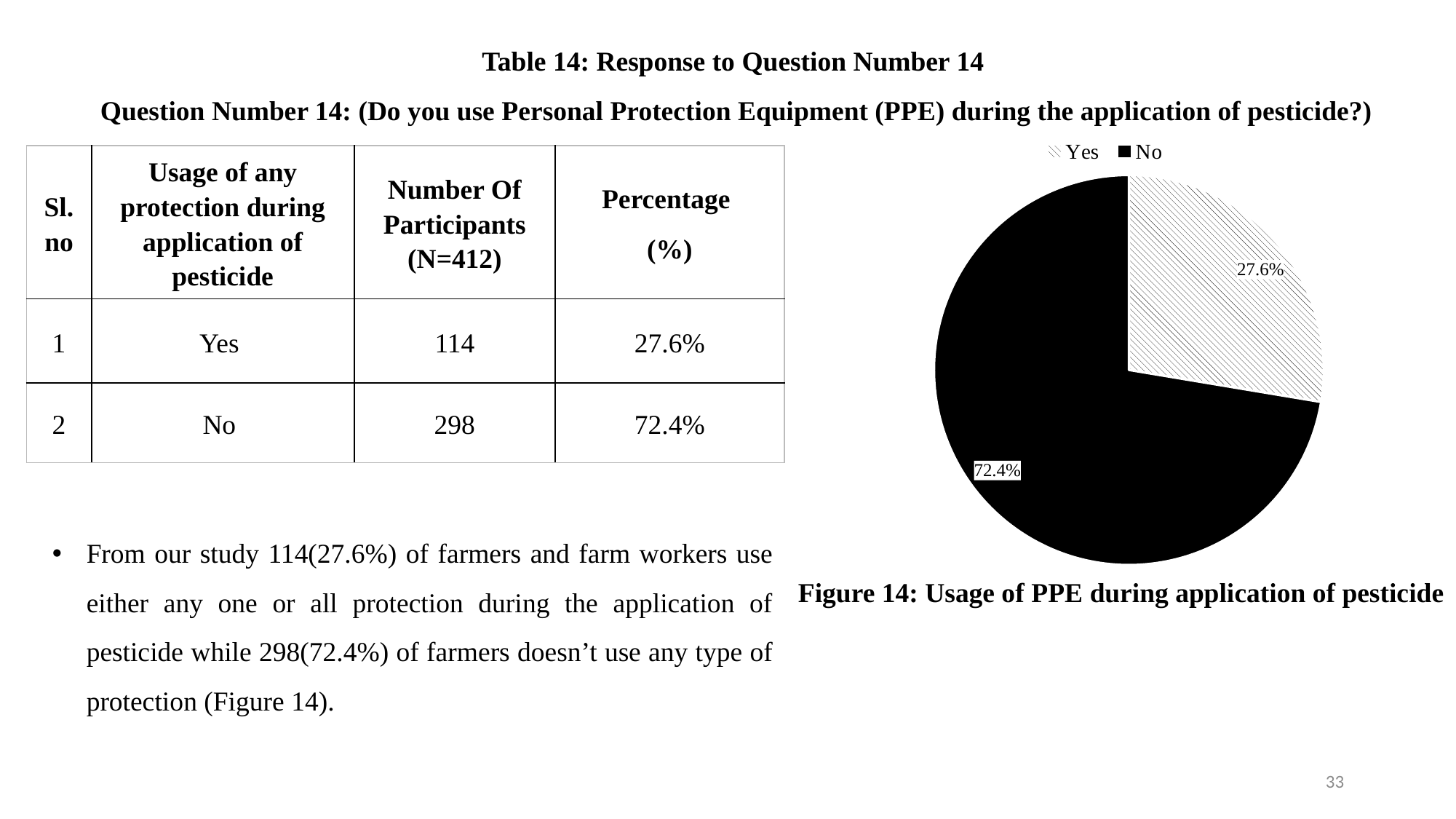
In the pie chart, what percentage is shown for the No slice? 72.4% Which slice of the pie chart is the largest? No What is the title of the figure containing the pie chart? Figure 14: Usage of PPE during application of pesticide In the pie chart, what percentage is shown for the Yes slice? 27.6% Which slice of the pie chart is the smallest? Yes What share of the pie does the No slice represent? 72.4% How many entries does the legend of the pie chart list? 2 What is the difference in percentage points between the No slice and the Yes slice in the pie chart? 44.8 In the pie chart, which slice is filled with a diagonal hatch pattern? Yes How many slices does the pie chart have? 2 In the pie chart, which is larger, the Yes slice or the No slice? No What type of chart is shown in Figure 14? pie chart